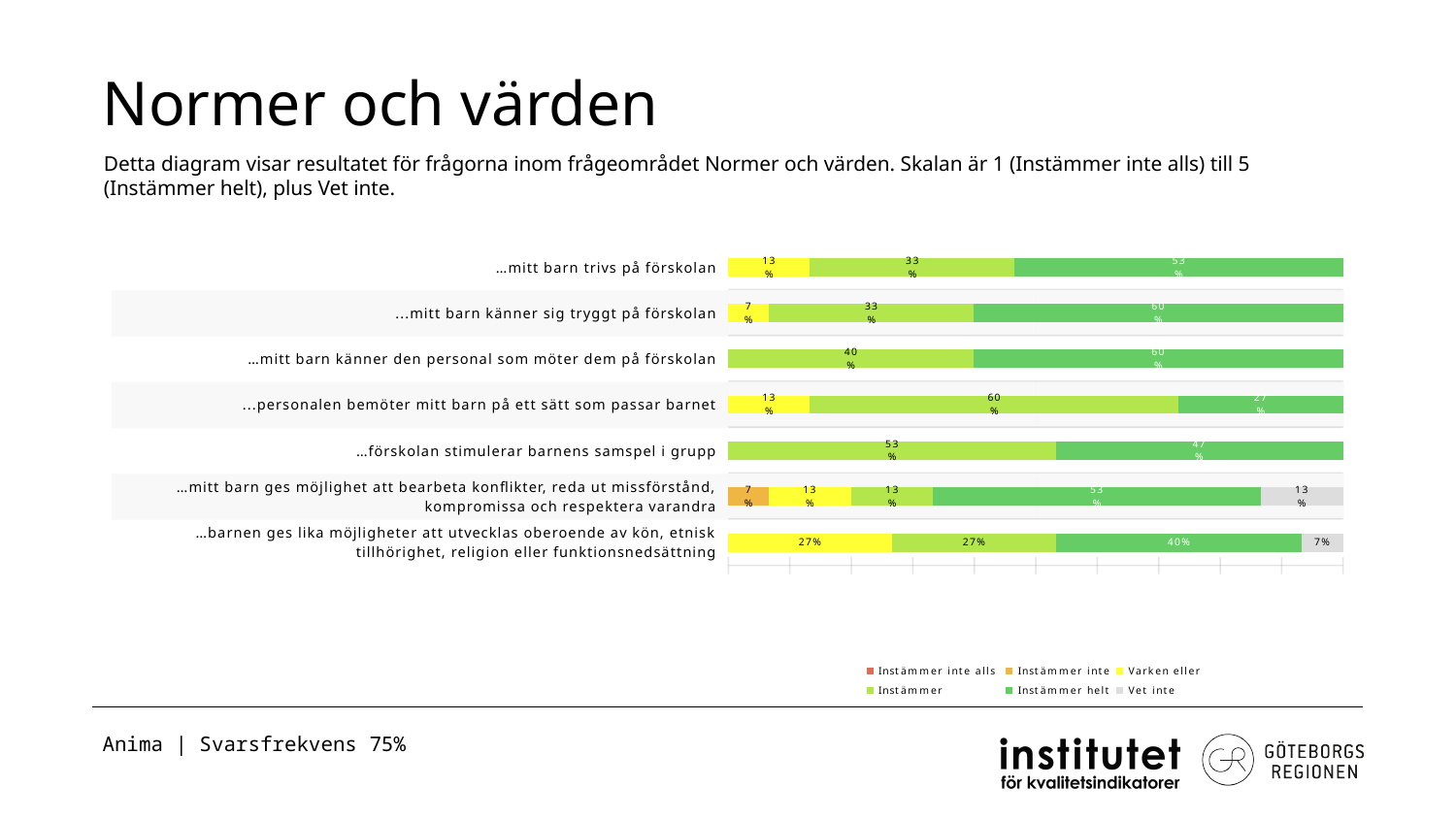
What is the 'Instämmer' value for '…mitt barn känner den personal som möter dem på förskolan'? 40% What is the combined share of 'Instämmer' and 'Instämmer helt' for '…mitt barn känner sig tryggt på förskolan'? 93% What is the 'Instämmer helt' value for '…mitt barn trivs på förskolan'? 53% What is the difference between the 'Instämmer helt' value for '…mitt barn känner sig tryggt på förskolan' and the 'Instämmer helt' value for '…mitt barn trivs på förskolan'? 7% Which is larger for '…förskolan stimulerar barnens samspel i grupp': 'Instämmer' or 'Instämmer helt'? Instämmer What is the title of the slide containing the chart? Normer och värden What kind of chart is shown on the slide? Stacked bar chart How many series does the legend list? 6 What is the 'Instämmer helt' value for '…personalen bemöter mitt barn på ett sätt som passar barnet'? 27% How many question categories are plotted in the chart? 7 What is the 'Instämmer inte' value for '…mitt barn ges möjlighet att bearbeta konflikter, reda ut missförstånd, kompromissa och respektera varandra'? 7% What is the 'Vet inte' value for '…barnen ges lika möjligheter att utvecklas oberoende av kön, etnisk tillhörighet, religion eller funktionsnedsättning'? 7%